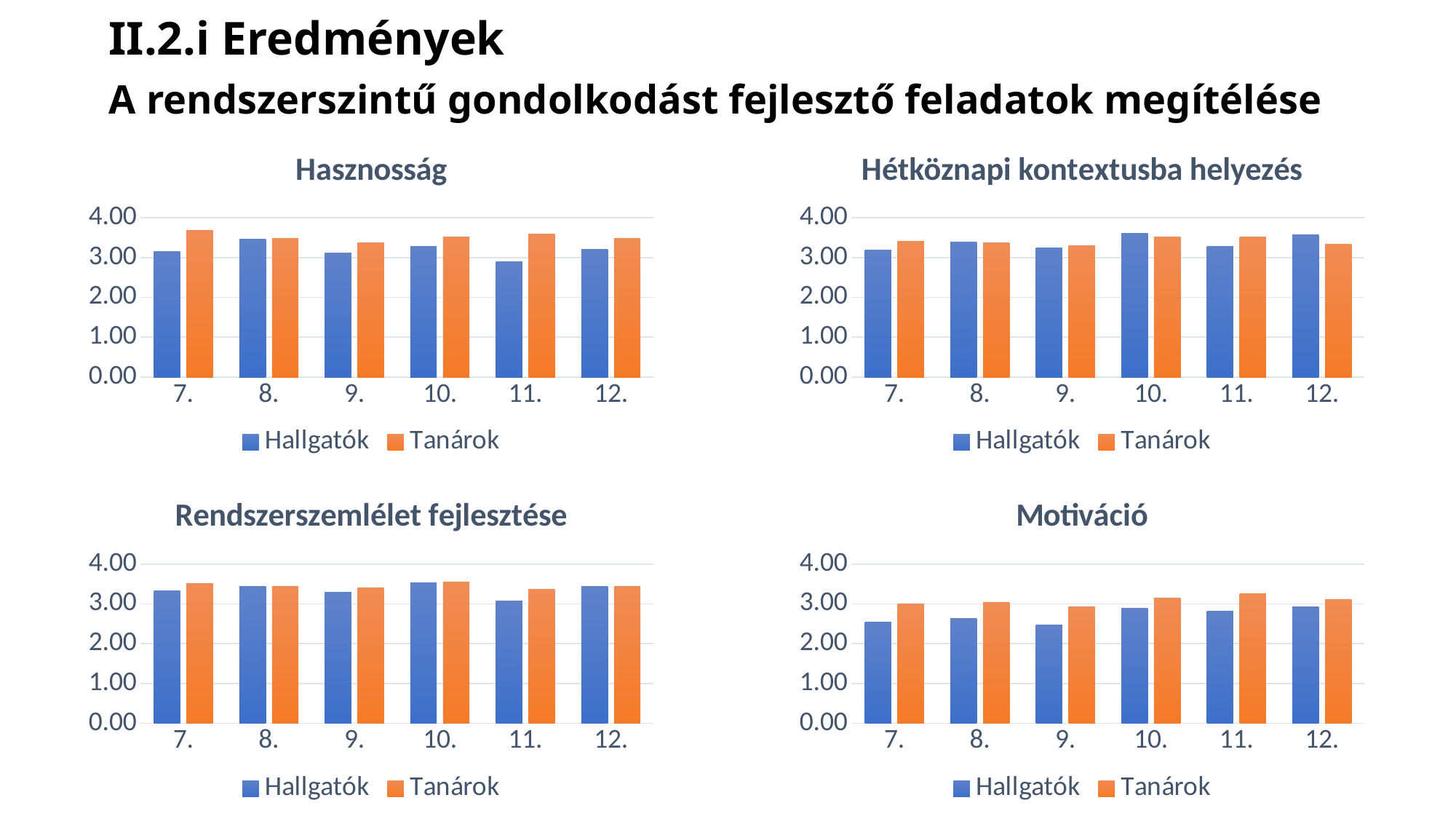
How many series does the legend of the "Rendszerszemlélet fejlesztése" chart list? 2 In the "Hasznosság" chart, which category has the lowest value for Hallgatók? 11. What kind of chart is the "Hasznosság" chart? bar chart In the "Hétköznapi kontextusba helyezés" chart, is the Tanárok value for 7. greater or less than 3.00? greater In the "Motiváció" chart, is the Hallgatók value for 7. greater or less than 3.00? less In the "Hasznosság" chart, is the Hallgatók value for 11. greater or less than 3.00? less In the "Motiváció" chart, which is larger for 9., Hallgatók or Tanárok? Tanárok In the "Rendszerszemlélet fejlesztése" chart, which category has the lowest value for Hallgatók? 11. In the "Hétköznapi kontextusba helyezés" chart, which is larger for 12., Hallgatók or Tanárok? Hallgatók In the "Hasznosság" chart, which is larger for 7., Hallgatók or Tanárok? Tanárok What is the title of the chart in the bottom-right of the slide? Motiváció How many categories are shown on the x axis of the "Motiváció" chart? 6